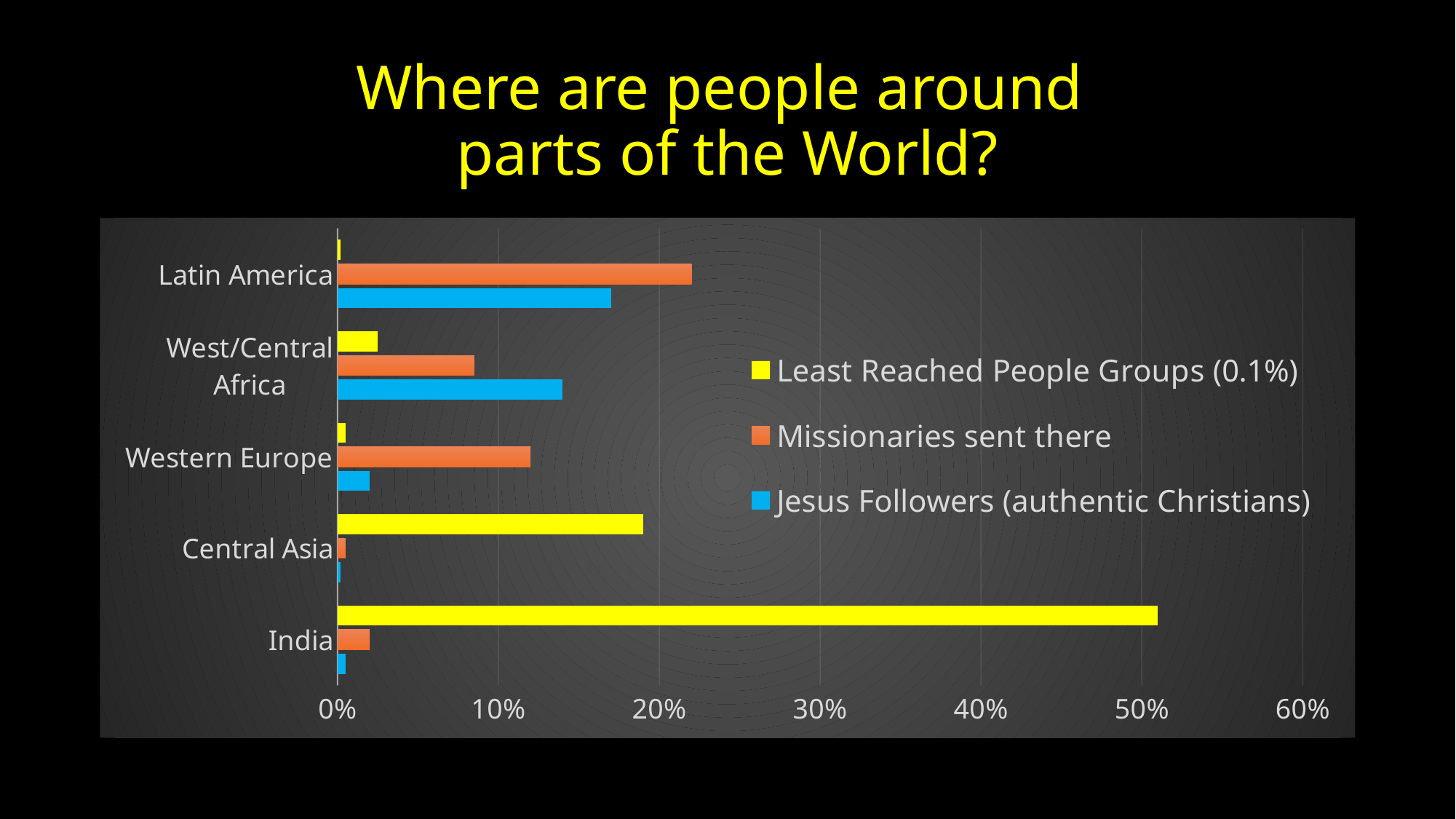
In Latin America, which is larger: Missionaries sent there or Jesus Followers (authentic Christians)? Missionaries sent there Is the value for Missionaries sent there in Latin America greater or less than 20%? greater What kind of chart is shown on the slide? bar chart Is the value for Least Reached People Groups (0.1%) in India greater or less than 40%? greater Which region has the highest value for Missionaries sent there? Latin America Which region has the highest value for Least Reached People Groups (0.1%)? India How many series does the legend list? 3 How many regions are listed on the chart? 5 Is the value for Jesus Followers (authentic Christians) in Western Europe greater or less than 10%? less In West/Central Africa, which is larger: Jesus Followers (authentic Christians) or Missionaries sent there? Jesus Followers (authentic Christians) Which region has the highest value for Jesus Followers (authentic Christians)? Latin America